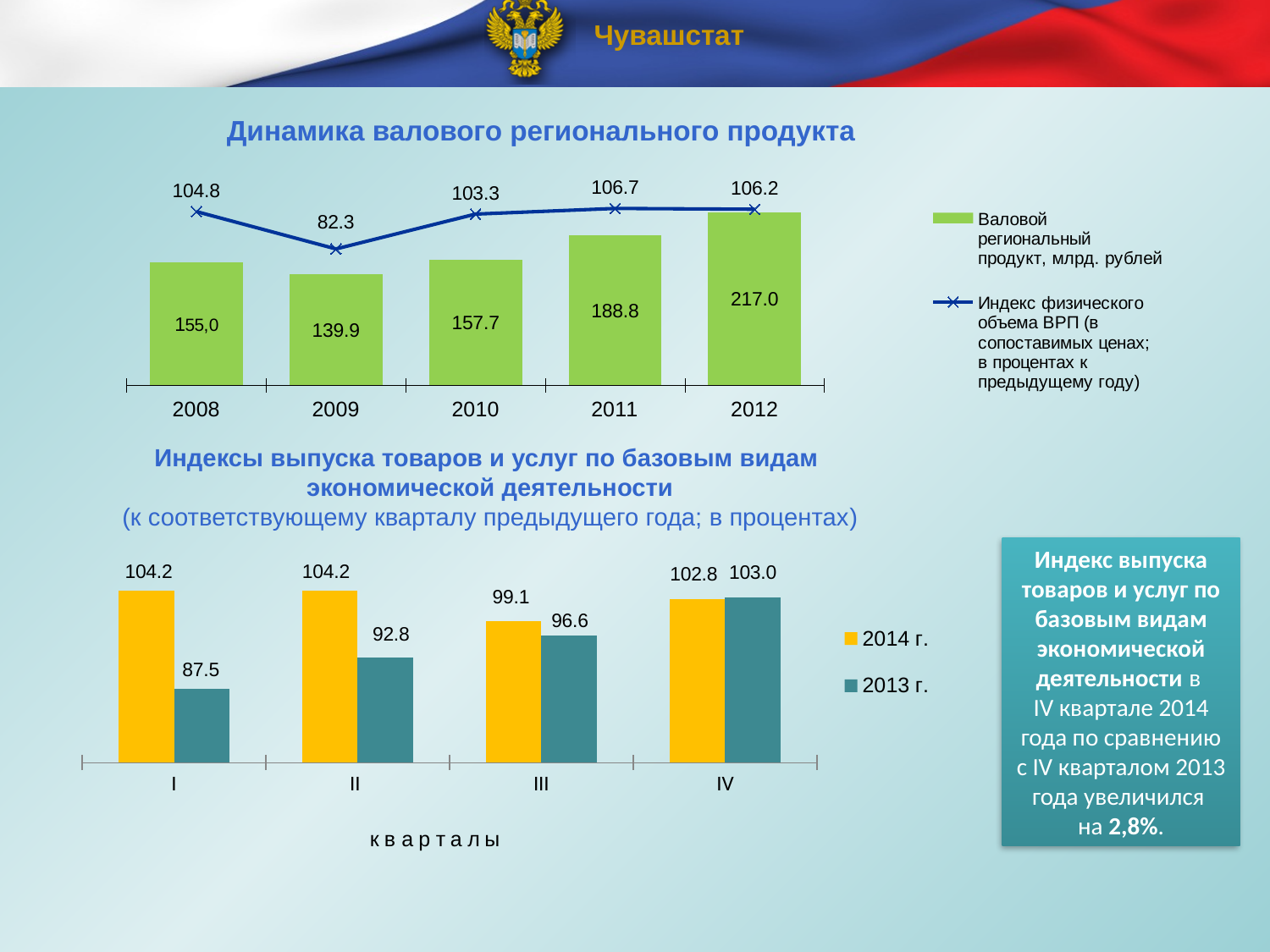
In the chart 'Индексы выпуска товаров и услуг по базовым видам экономической деятельности', do the 2013 г. values rise or fall from quarter I to quarter IV? rise In the chart 'Динамика валового регионального продукта', how many years are shown on the x axis? 5 In the chart 'Динамика валового регионального продукта', how many series does the legend list? 2 In the chart 'Динамика валового регионального продукта', which year has the lowest physical volume index? 2009 In the chart 'Индексы выпуска товаров и услуг по базовым видам экономической деятельности', what is the value for 2013 г. in quarter I? 87.5 In the chart 'Динамика валового регионального продукта', what is the difference between the gross regional product in 2012 and in 2011? 28.2 In the chart 'Динамика валового регионального продукта', what is the gross regional product value for 2011? 188.8 In the chart 'Динамика валового регионального продукта', what is the physical volume index value for 2009? 82.3 What kind of chart is 'Индексы выпуска товаров и услуг по базовым видам экономической деятельности'? bar chart In the chart 'Индексы выпуска товаров и услуг по базовым видам экономической деятельности', what is the value for 2014 г. in quarter III? 99.1 In the chart 'Индексы выпуска товаров и услуг по базовым видам экономической деятельности', which is larger in quarter IV: the 2014 г. value or the 2013 г. value? 2013 г. In the chart 'Динамика валового регионального продукта', which year has the highest gross regional product? 2012